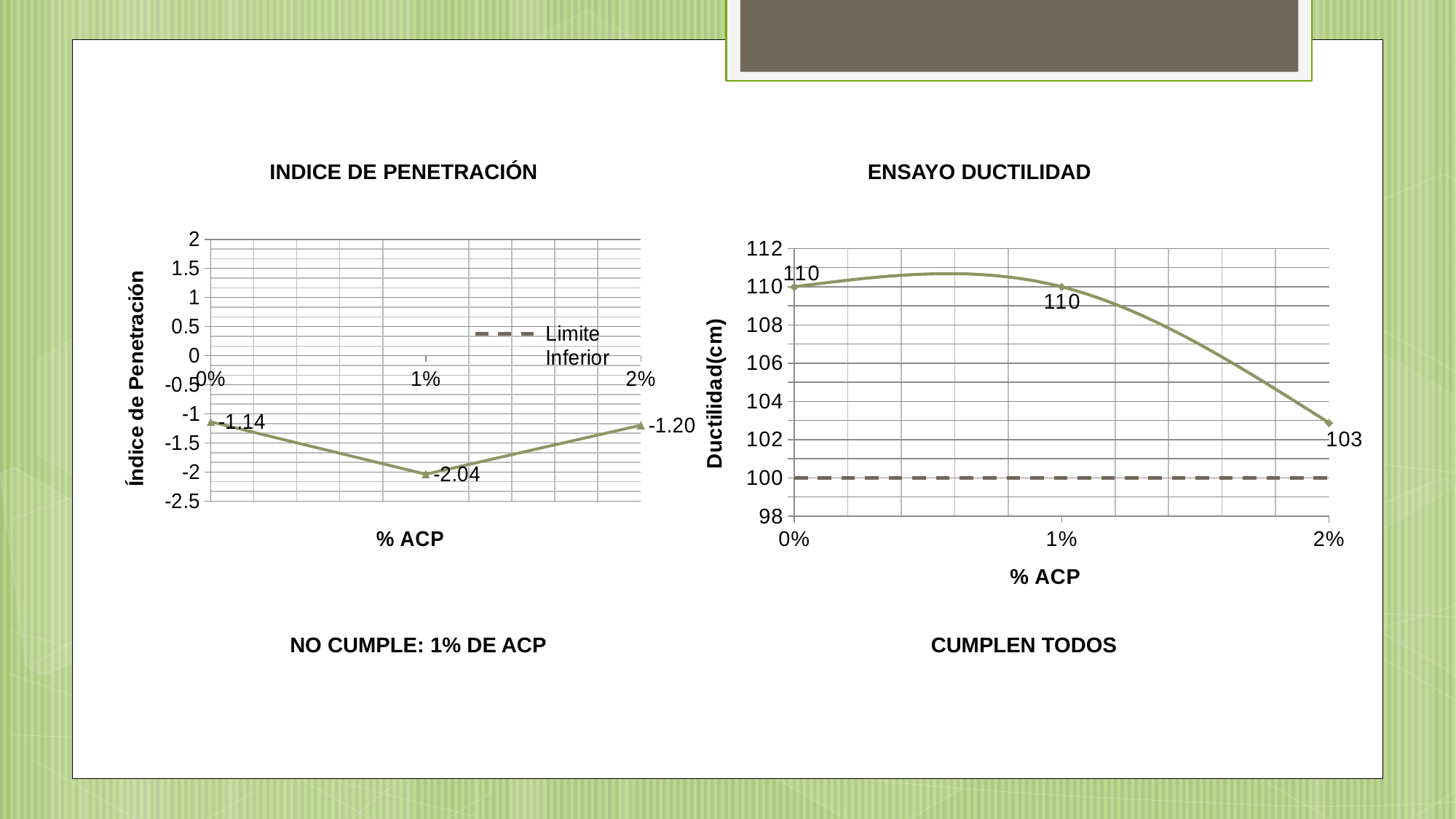
In the INDICE DE PENETRACIÓN chart, what is the value at 1% ACP? -2.04 In the INDICE DE PENETRACIÓN chart, what is the value at 0% ACP? -1.14 In the ENSAYO DUCTILIDAD chart, is the ductility at 2% ACP greater or less than 100? greater In the INDICE DE PENETRACIÓN chart, at which % ACP is the index lowest? 1% In the ENSAYO DUCTILIDAD chart, at which % ACP is the ductility lowest? 2% In the INDICE DE PENETRACIÓN chart, what does the legend entry for the dashed line say? Limite Inferior What kind of chart is ENSAYO DUCTILIDAD? Line chart In the ENSAYO DUCTILIDAD chart, what is the difference between the ductility at 1% and 2% ACP? 7 In the ENSAYO DUCTILIDAD chart, what is the ductility at 2% ACP? 103 In the INDICE DE PENETRACIÓN chart, what is the difference between the values at 0% and 2% ACP? 0.06 In the ENSAYO DUCTILIDAD chart, what is the ductility at 0% ACP? 110 In the INDICE DE PENETRACIÓN chart, how many data points are plotted on the solid line? 3